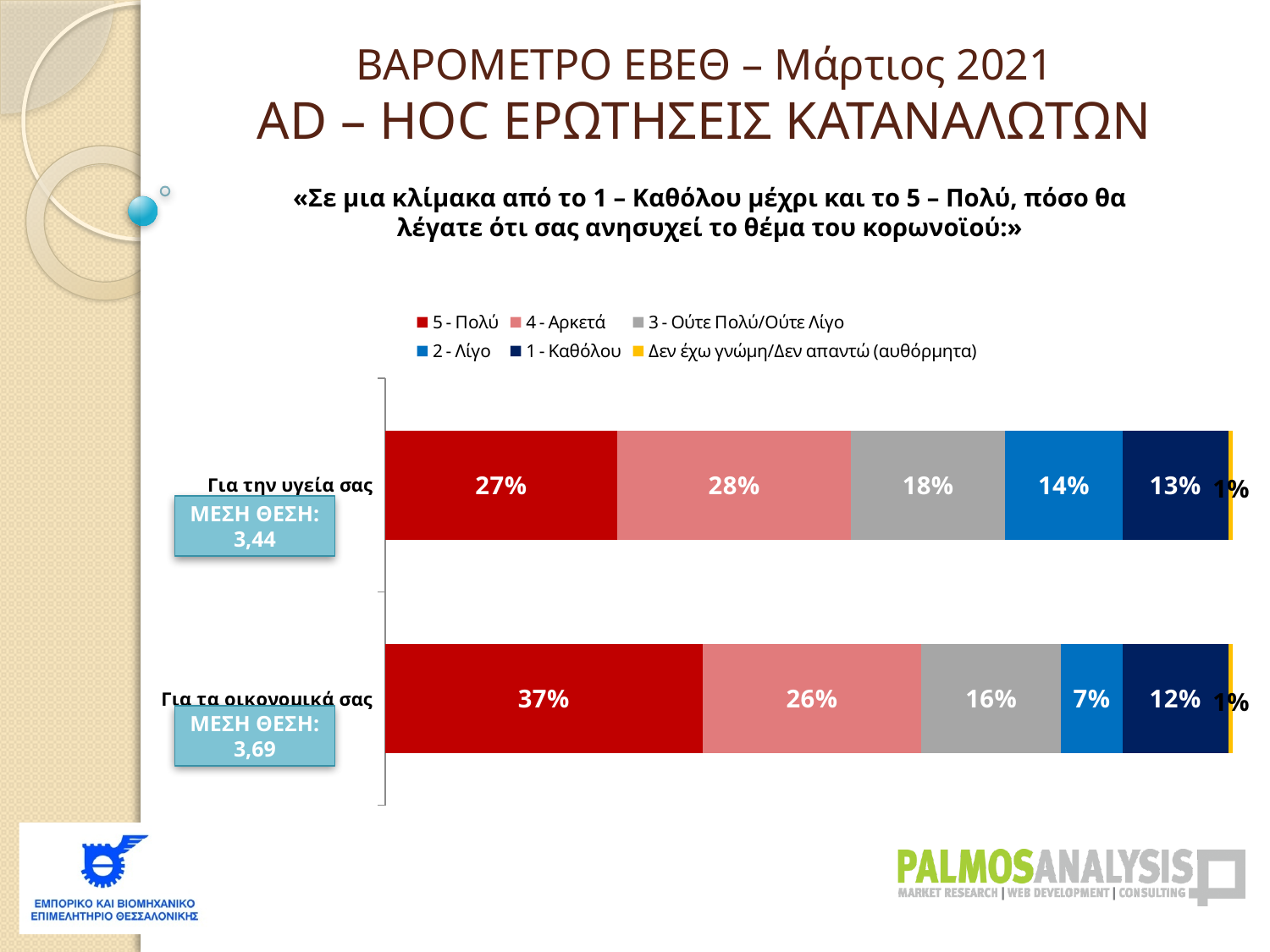
How many categories (bars) are plotted in the chart? 2 What is the value of "5 - Πολύ" for "Για την υγεία σας"? 27% Which category has the higher value for "5 - Πολύ"? Για τα οικονομικά σας Which series has the largest value in the "Για την υγεία σας" bar? 4 - Αρκετά How many series does the legend list? 6 What is the mean position (ΜΕΣΗ ΘΕΣΗ) shown for "Για τα οικονομικά σας"? 3,69 What is the value of "1 - Καθόλου" for "Για την υγεία σας"? 13% What is the difference between the "4 - Αρκετά" values for "Για την υγεία σας" and "Για τα οικονομικά σας"? 2% What kind of chart is shown on the slide? stacked bar chart What is the difference between the "2 - Λίγο" values for "Για την υγεία σας" and "Για τα οικονομικά σας"? 7% What is the value of "2 - Λίγο" for "Για τα οικονομικά σας"? 7% What is the value of "5 - Πολύ" for "Για τα οικονομικά σας"? 37%